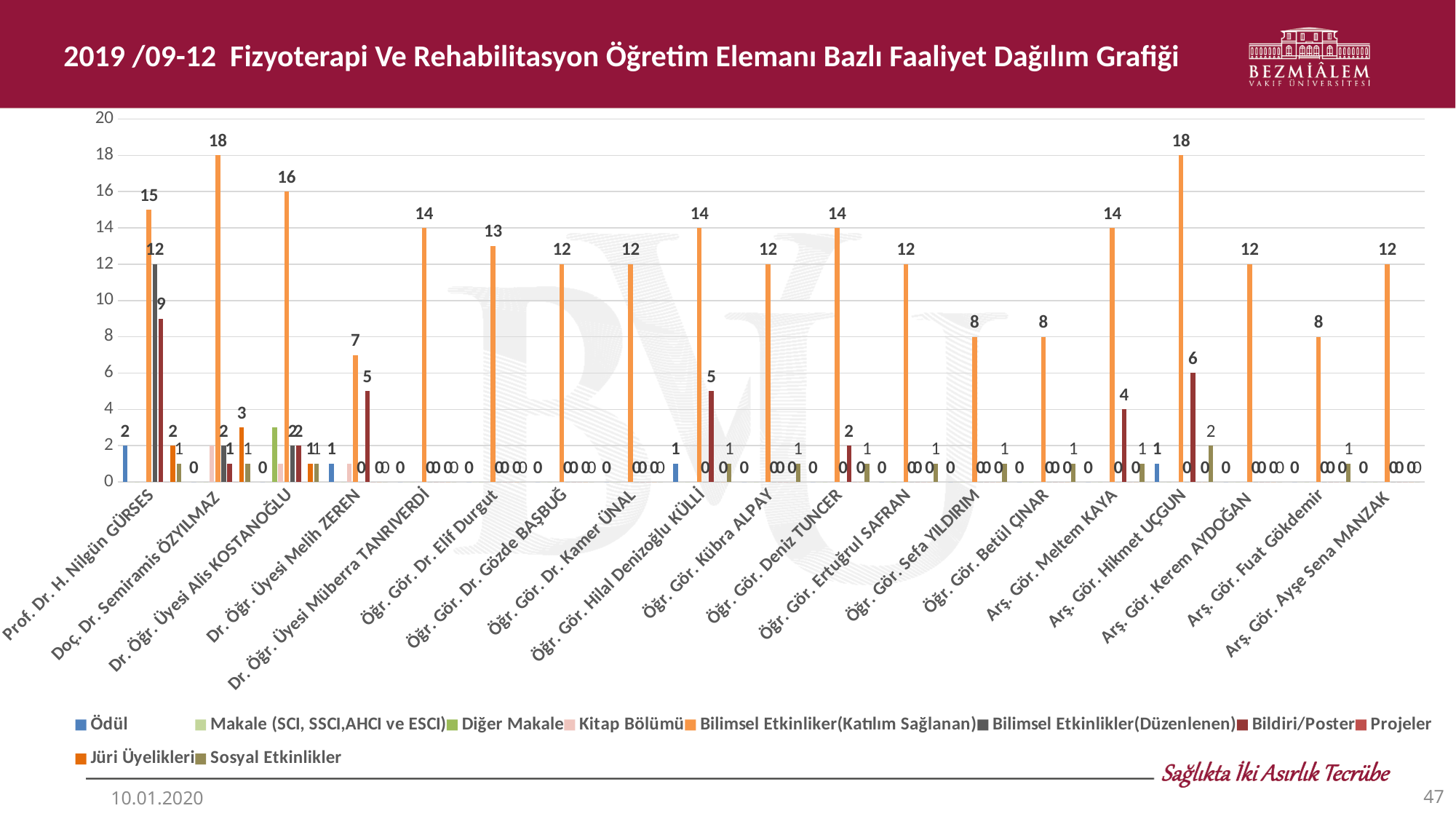
What is the difference between the Bilimsel Etkinliker(Katılım Sağlanan) values of Doç. Dr. Semiramis ÖZYILMAZ and Öğr. Gör. Dr. Elif Durgut? 5 Which instructor has the lowest Bilimsel Etkinliker(Katılım Sağlanan) value? Dr. Öğr. Üyesi Melih ZEREN What is the Bildiri/Poster value for Prof. Dr. H. Nilgün GÜRSES? 9 What is the Bilimsel Etkinliker(Katılım Sağlanan) value for Prof. Dr. H. Nilgün GÜRSES? 15 What is the Bilimsel Etkinlikler(Düzenlenen) value for Prof. Dr. H. Nilgün GÜRSES? 12 What type of chart is shown on the slide? bar chart What is the title of the chart? 2019 /09-12 Fizyoterapi Ve Rehabilitasyon Öğretim Elemanı Bazlı Faaliyet Dağılım Grafiği What is the Bildiri/Poster value for Arş. Gör. Hikmet UÇGUN? 6 What is the Bilimsel Etkinliker(Katılım Sağlanan) value for Dr. Öğr. Üyesi Alis KOSTANOĞLU? 16 How many series does the legend list? 10 How many instructors (categories) are shown on the x axis? 19 Which is larger: the Bildiri/Poster value for Arş. Gör. Meltem KAYA or for Arş. Gör. Hikmet UÇGUN? Arş. Gör. Hikmet UÇGUN